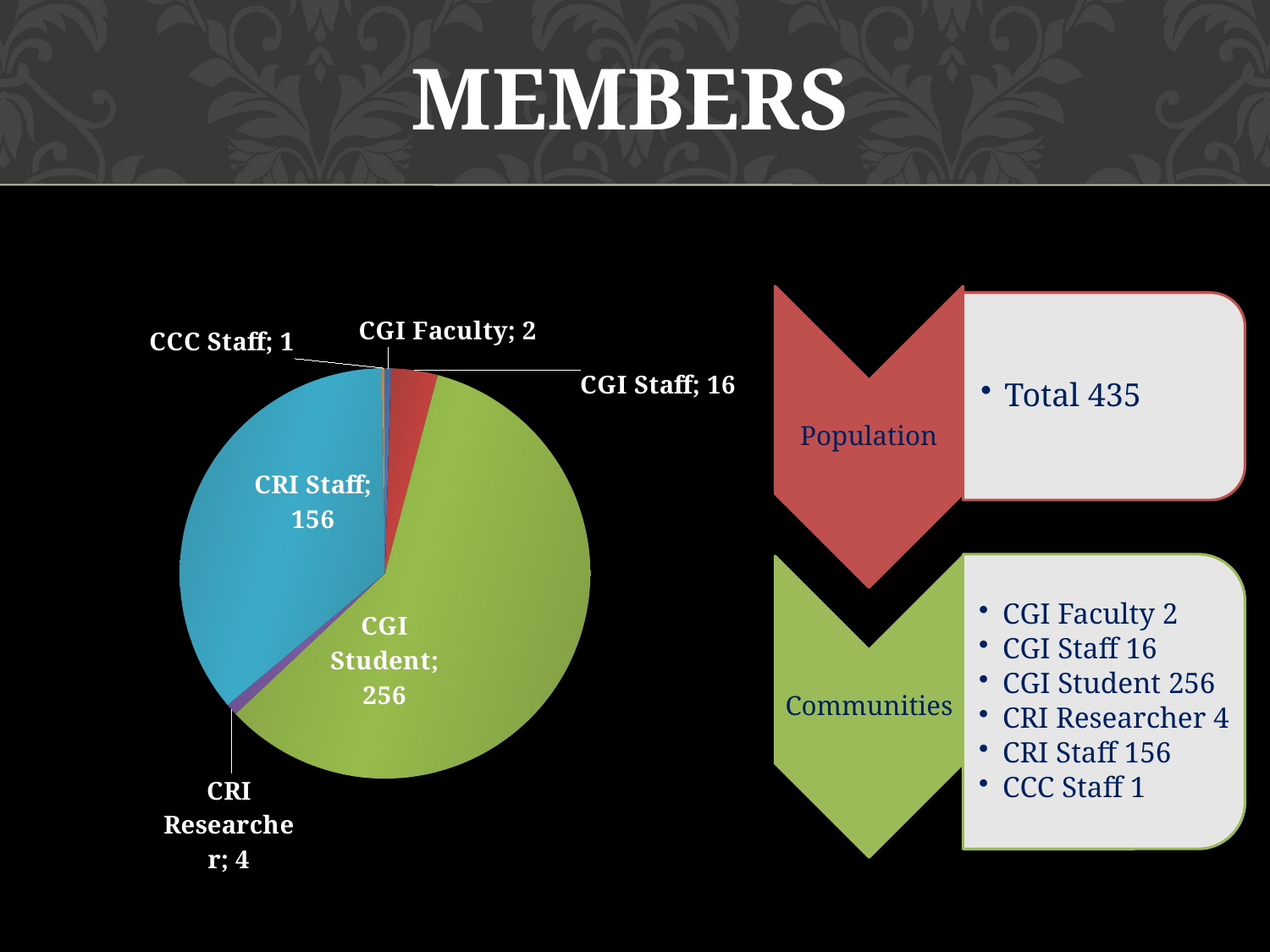
What is the total of all the slices in the pie chart? 435 What is the value for CGI Staff in the pie chart? 16 Which category has the smallest slice in the pie chart? CCC Staff What is the value for CRI Staff in the pie chart? 156 What is the value for CRI Researcher in the pie chart? 4 Which is larger in the pie chart, CGI Staff or CRI Researcher? CGI Staff What is the difference between the CGI Student and CRI Staff values in the pie chart? 100 What kind of chart is shown on the slide? Pie chart Which category has the largest slice in the pie chart? CGI Student What colour is the CRI Staff slice in the pie chart? Blue What is the value for CGI Student in the pie chart? 256 How many slices does the pie chart have? 6